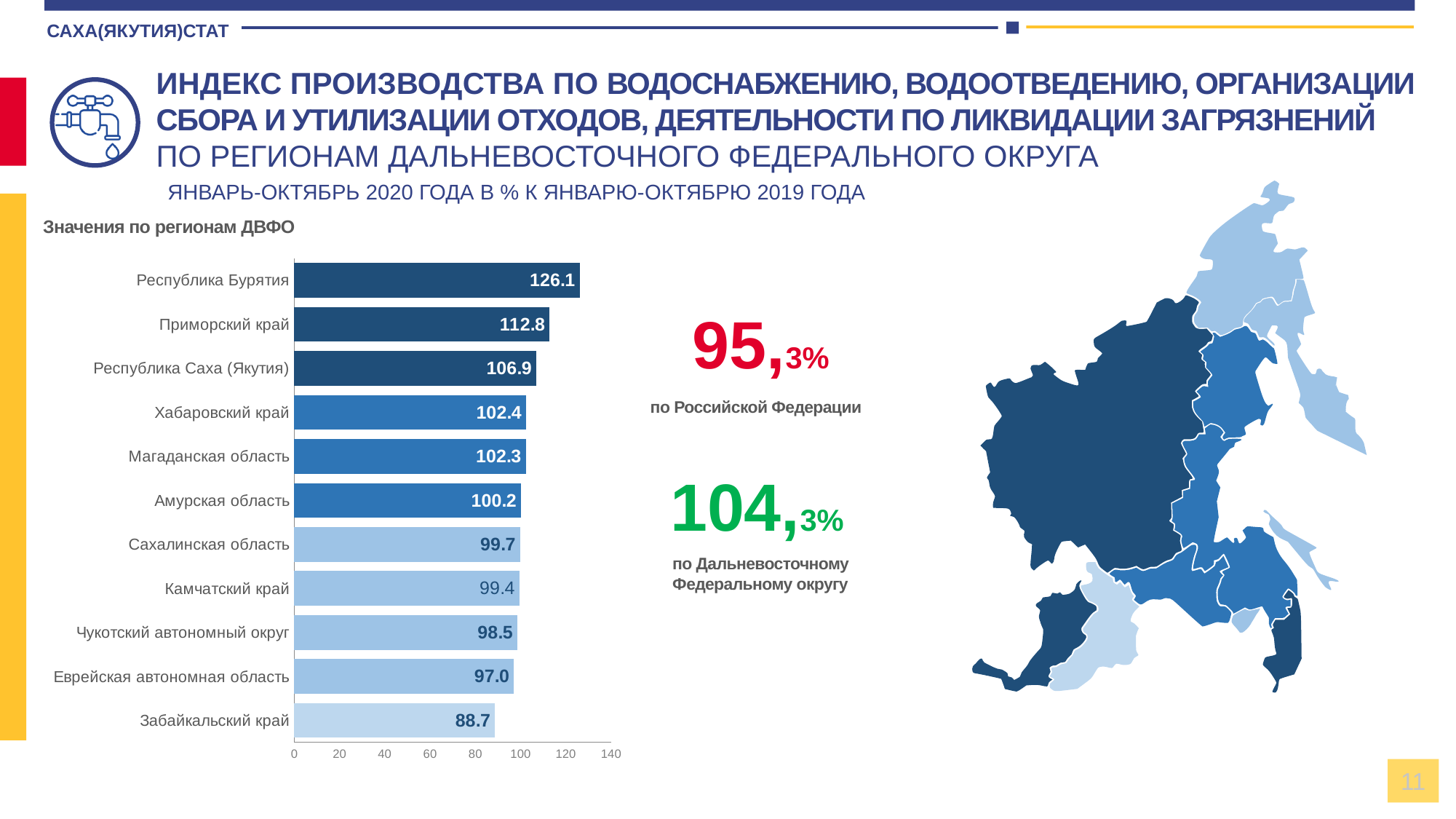
What is the highest tick value shown on the horizontal axis? 140 What is the difference between the values for Приморский край and Республика Саха (Якутия)? 5.9 Is the value for Приморский край greater or less than 100? greater How many regions are shown in the bar chart? 11 What is the value for Чукотский автономный округ? 98.5 What is the value for Забайкальский край? 88.7 Which is larger, the value for Хабаровский край or the value for Сахалинская область? Хабаровский край What is the difference between the values for Республика Бурятия and Забайкальский край? 37.4 What is the value for Республика Саха (Якутия)? 106.9 Which region has the highest value? Республика Бурятия What kind of chart is shown on the slide? bar chart Which region has the lowest value? Забайкальский край